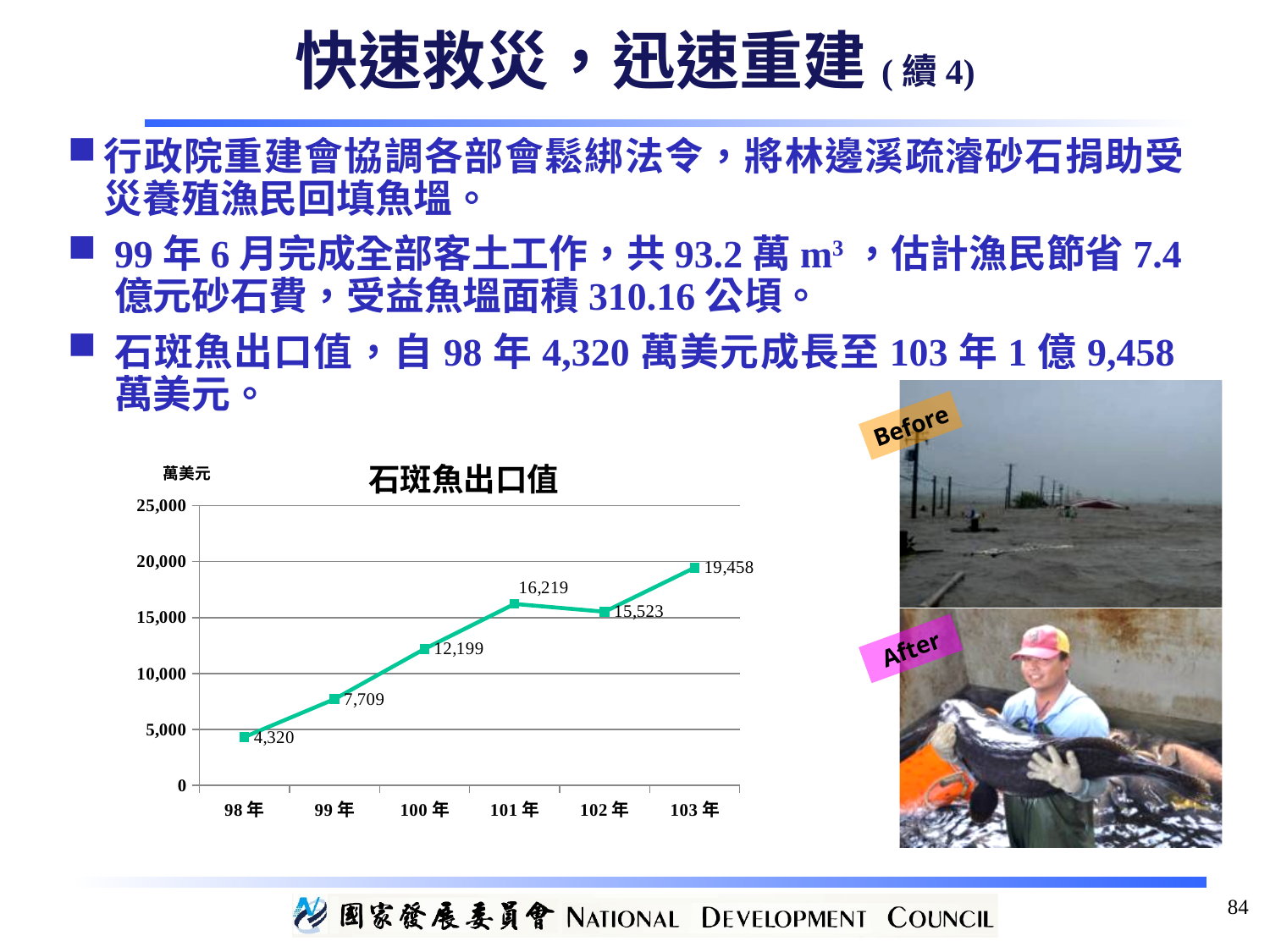
How many years are plotted on the x axis of the chart? 6 What is the value for 100年 in the chart? 12,199 What is the value for 102年 in the chart? 15,523 Which year has the highest value in the chart? 103年 Does the value generally rise or fall from 98年 to 103年? rise What is the value for 98年 in the chart? 4,320 What is the title of the chart? 石斑魚出口值 What type of chart is shown on the slide? line chart What is the difference between the values for 103年 and 98年? 15,138 Which year has the lowest value in the chart? 98年 What unit is shown above the y axis of the chart? 萬美元 Which is larger, the value for 101年 or the value for 102年? 101年